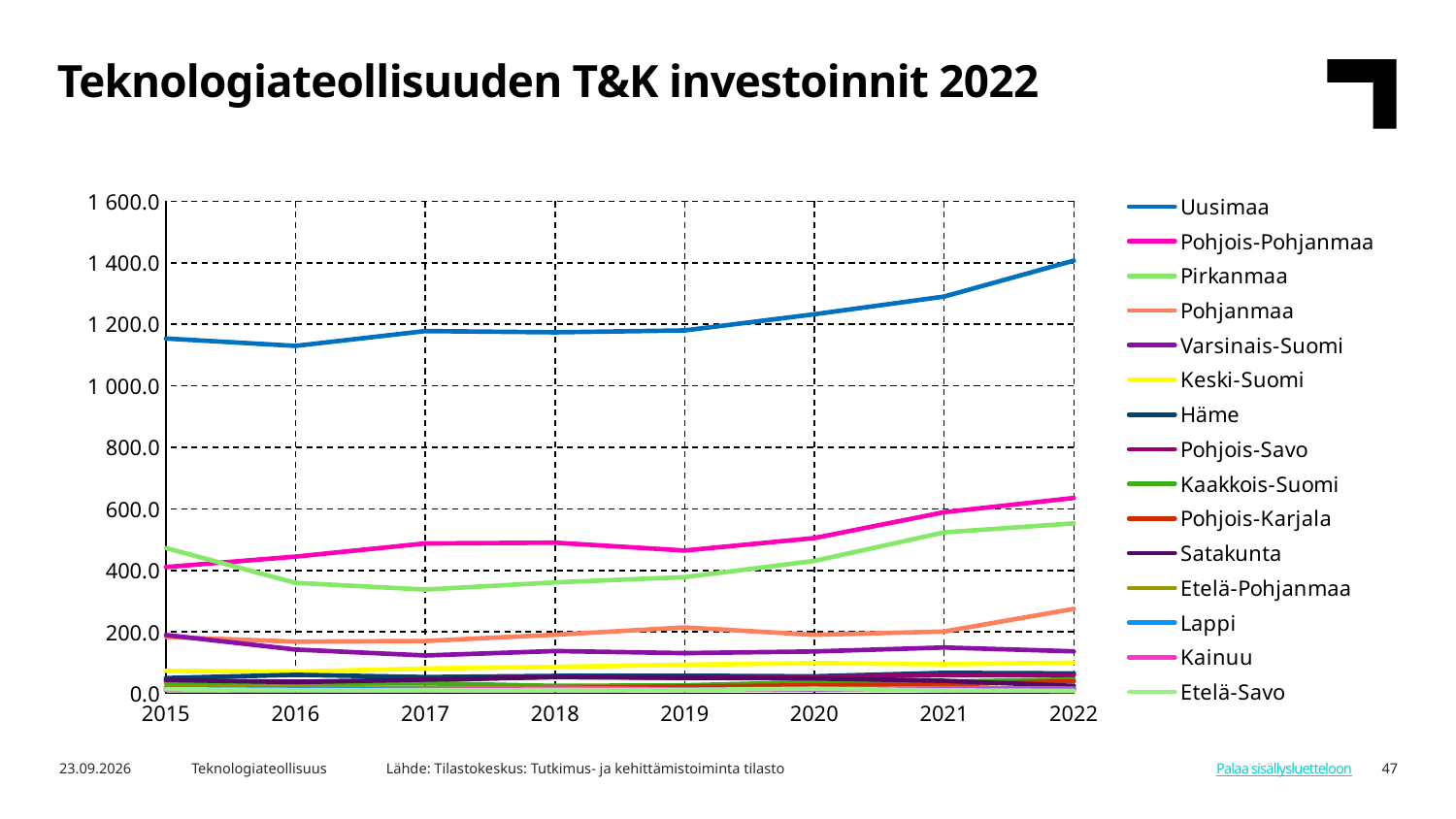
Is the value for Pohjois-Pohjanmaa in 2022 greater or less than 600.0? greater Is the value for Pohjanmaa in 2022 greater or less than 200.0? greater What kind of chart is shown on the slide? line chart Is the value for Uusimaa in 2016 greater or less than 1 200.0? less What is the title of the slide? Teknologiateollisuuden T&K investoinnit 2022 How many years are shown on the x axis? 8 How many series does the legend list? 15 Which series has the highest value in 2022? Uusimaa Does the value for Uusimaa rise or fall from 2019 to 2022? rise Which series has the second highest value in 2022? Pohjois-Pohjanmaa In 2015, which is larger: the value for Pirkanmaa or the value for Pohjois-Pohjanmaa? Pirkanmaa